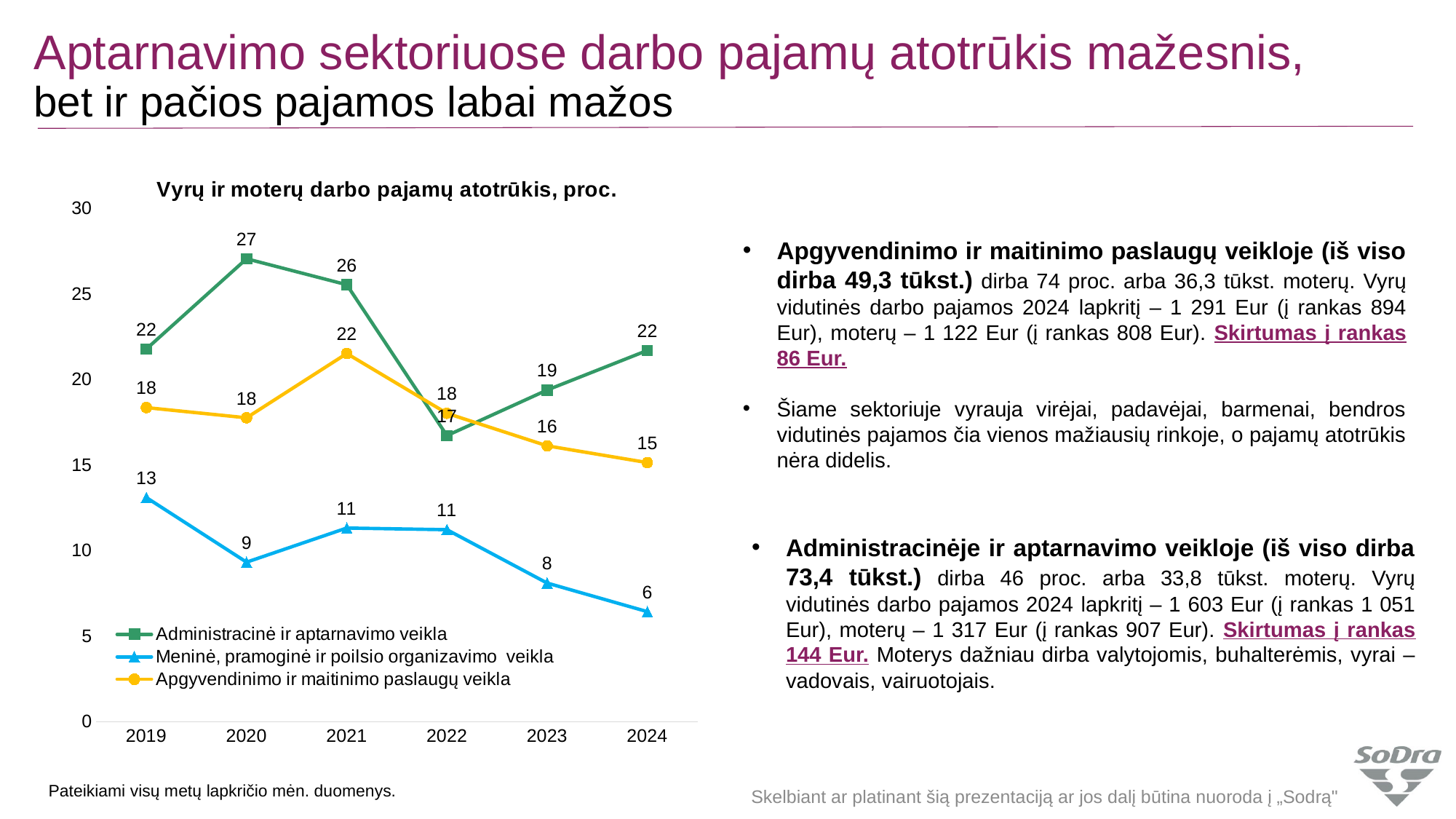
What is the difference between Administracinė ir aptarnavimo veikla and Meninė, pramoginė ir poilsio organizavimo veikla in 2024? 16 Which series has the higher value in 2023: Administracinė ir aptarnavimo veikla or Apgyvendinimo ir maitinimo paslaugų veikla? Administracinė ir aptarnavimo veikla What is the value for Administracinė ir aptarnavimo veikla in 2020? 27 In which year does Meninė, pramoginė ir poilsio organizavimo veikla have its lowest value? 2024 How many years are shown on the x axis of the chart? 6 What type of chart is shown on the slide? line chart How many series does the chart legend list? 3 What is the value for Apgyvendinimo ir maitinimo paslaugų veikla in 2021? 22 What is the value for Meninė, pramoginė ir poilsio organizavimo veikla in 2024? 6 In which year does Administracinė ir aptarnavimo veikla reach its highest value? 2020 Does the value for Meninė, pramoginė ir poilsio organizavimo veikla rise or fall from 2022 to 2024? fall What is the title of the chart? Vyrų ir moterų darbo pajamų atotrūkis, proc.